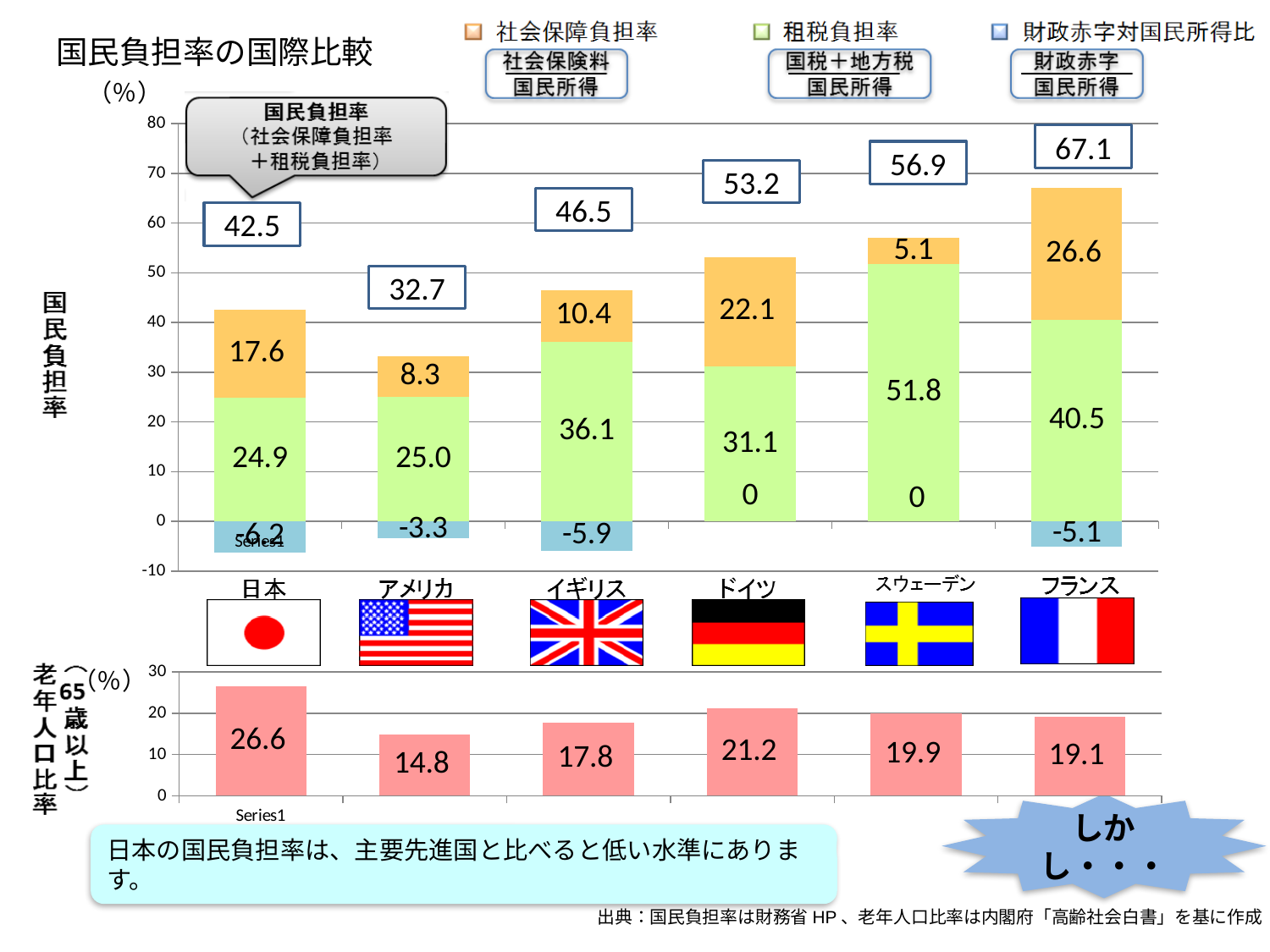
In the bottom chart (老年人口比率), what is the value for ドイツ? 21.2 In the top chart (国民負担率の国際比較), what is the 租税負担率 value for スウェーデン? 51.8 In the bottom chart (老年人口比率), which country has the highest value? 日本 In the top chart (国民負担率の国際比較), which is larger: the 社会保障負担率 of ドイツ or of イギリス? ドイツ In the top chart (国民負担率の国際比較), which country has the lowest 国民負担率 (boxed total)? アメリカ What kind of chart is the bottom chart (老年人口比率)? bar chart In the top chart (国民負担率の国際比較), what is the 財政赤字対国民所得比 value for 日本? -6.2 How many series does the legend of the top chart (国民負担率の国際比較) list? 3 How many countries are shown in the bottom chart (老年人口比率)? 6 In the top chart (国民負担率の国際比較), what is the difference between the 国民負担率 of フランス and 日本? 24.6 In the top chart (国民負担率の国際比較), what is the 社会保障負担率 value for フランス? 26.6 In the top chart (国民負担率の国際比較), which country has the highest 国民負担率 (boxed total)? フランス